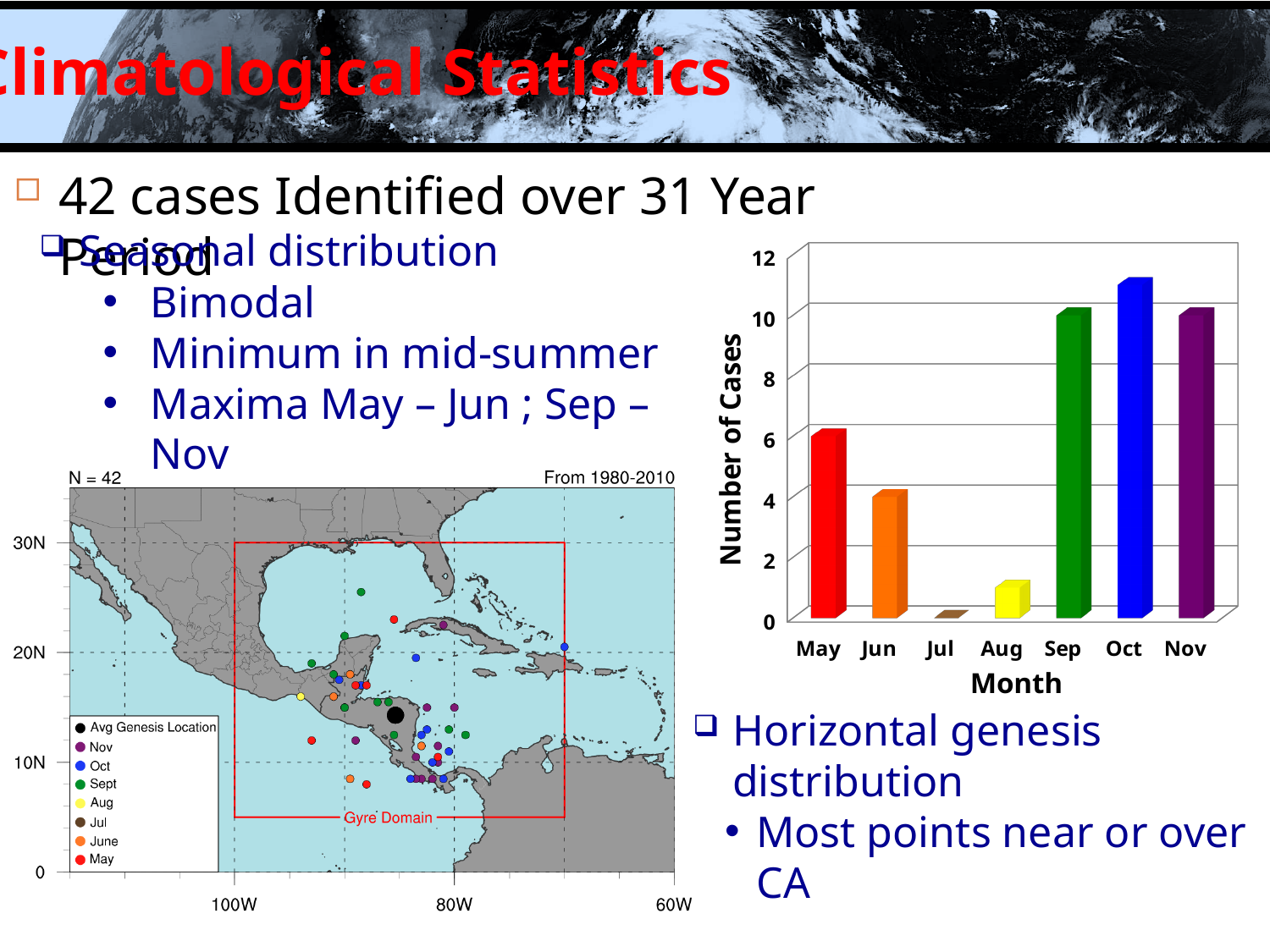
In the bar chart, which month has the lowest number of cases? Jul In the bar chart, what is the number of cases for Jun? 4 In the bar chart, what is the number of cases for Sep? 10 In the bar chart, is the number of cases for Aug greater or less than 2? less In the bar chart, which month has more cases, Jun or Sep? Sep In the bar chart, what is the difference between the number of cases in May and Jun? 2 In the bar chart, which month has the highest number of cases? Oct In the bar chart, what is the number of cases for May? 6 What is the y-axis title of the bar chart? Number of Cases How many months are shown on the x axis of the bar chart? 7 In the bar chart, what is the number of cases for Jul? 0 In the bar chart, is the number of cases for Oct greater or less than 10? greater